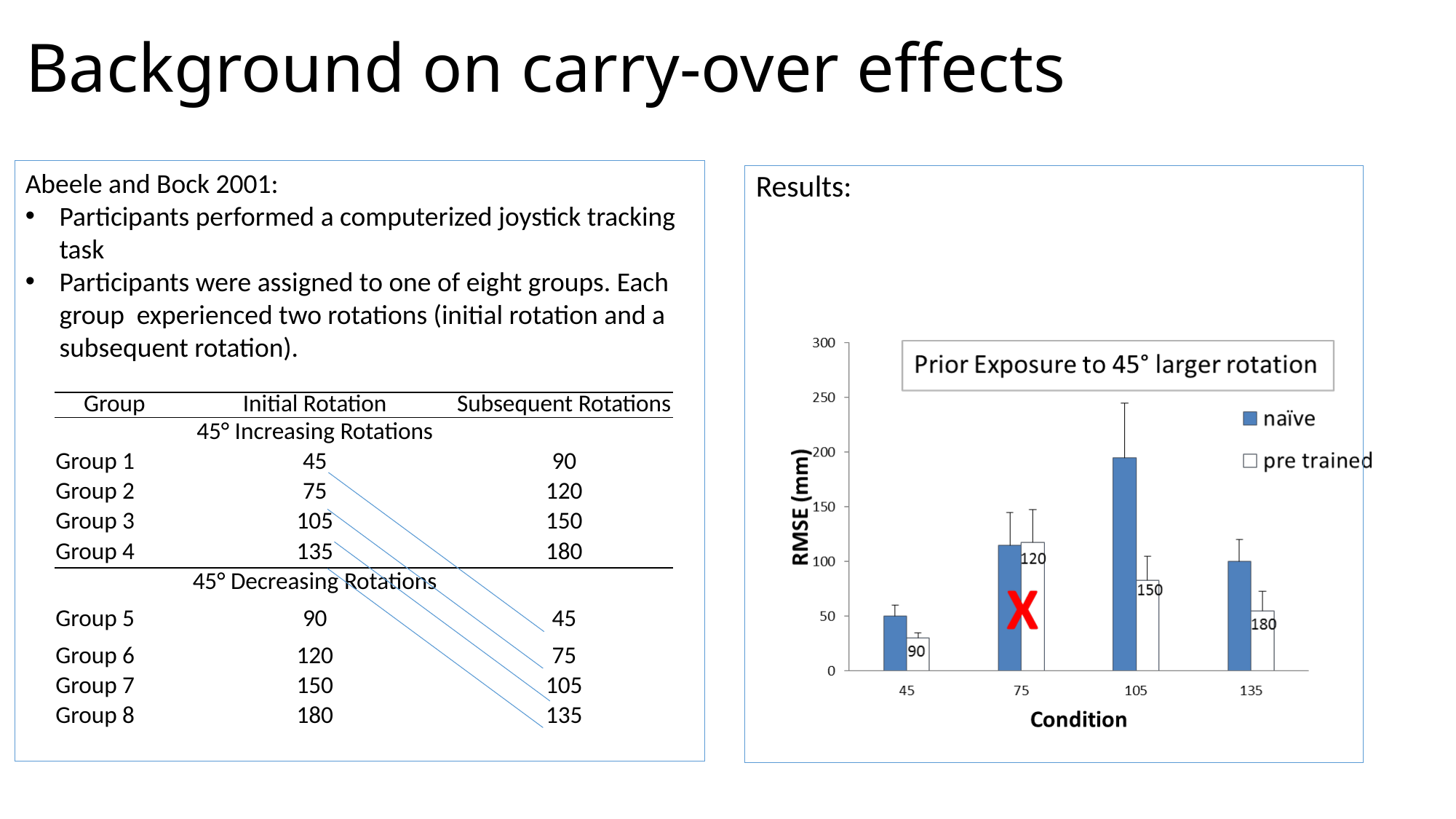
In the Results chart, at which condition is the naïve series highest? 105 In the Results chart, is the pre trained value at condition 105 greater or less than 100? less In the Results chart, is the pre trained value at condition 45 greater or less than 50? less What kind of chart is shown in the Results panel? bar chart In the Results chart, at condition 105, which series has the larger RMSE: naïve or pre trained? naïve In the Results chart, at which condition is the naïve series lowest? 45 How many series does the legend of the Results chart list? 2 In the Results chart, at condition 135, which series has the larger RMSE: naïve or pre trained? naïve How many conditions are shown on the x axis of the Results chart? 4 What title is shown inside the Results chart? Prior Exposure to 45° larger rotation What is the y-axis label of the Results chart? RMSE (mm) In the Results chart, is the naïve value at condition 105 greater or less than 150? greater